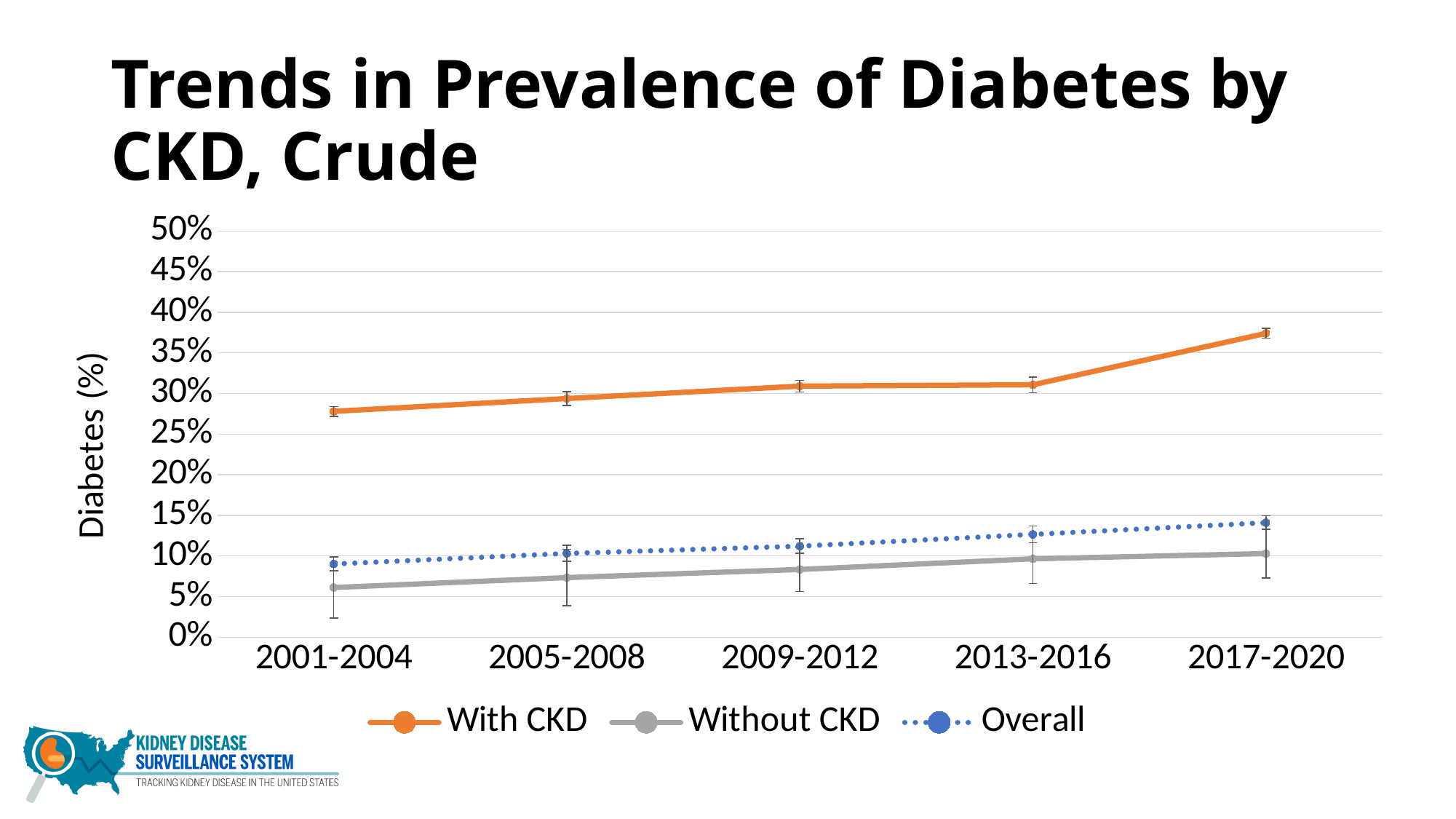
Which series has the highest diabetes prevalence across all periods? With CKD Is the With CKD value for 2001-2004 greater or less than 30%? less How many time periods are shown on the x axis? 5 Which series has the lowest diabetes prevalence across all periods? Without CKD In which period is the With CKD value lowest? 2001-2004 What is the label on the y axis? Diabetes (%) In which period is the With CKD value highest? 2017-2020 Does the Without CKD series rise or fall from 2001-2004 to 2017-2020? rise Is the Without CKD value for 2001-2004 greater or less than 10%? less How many series does the legend list? 3 Is the With CKD value for 2017-2020 greater or less than 35%? greater What kind of chart is shown on the slide? Line chart